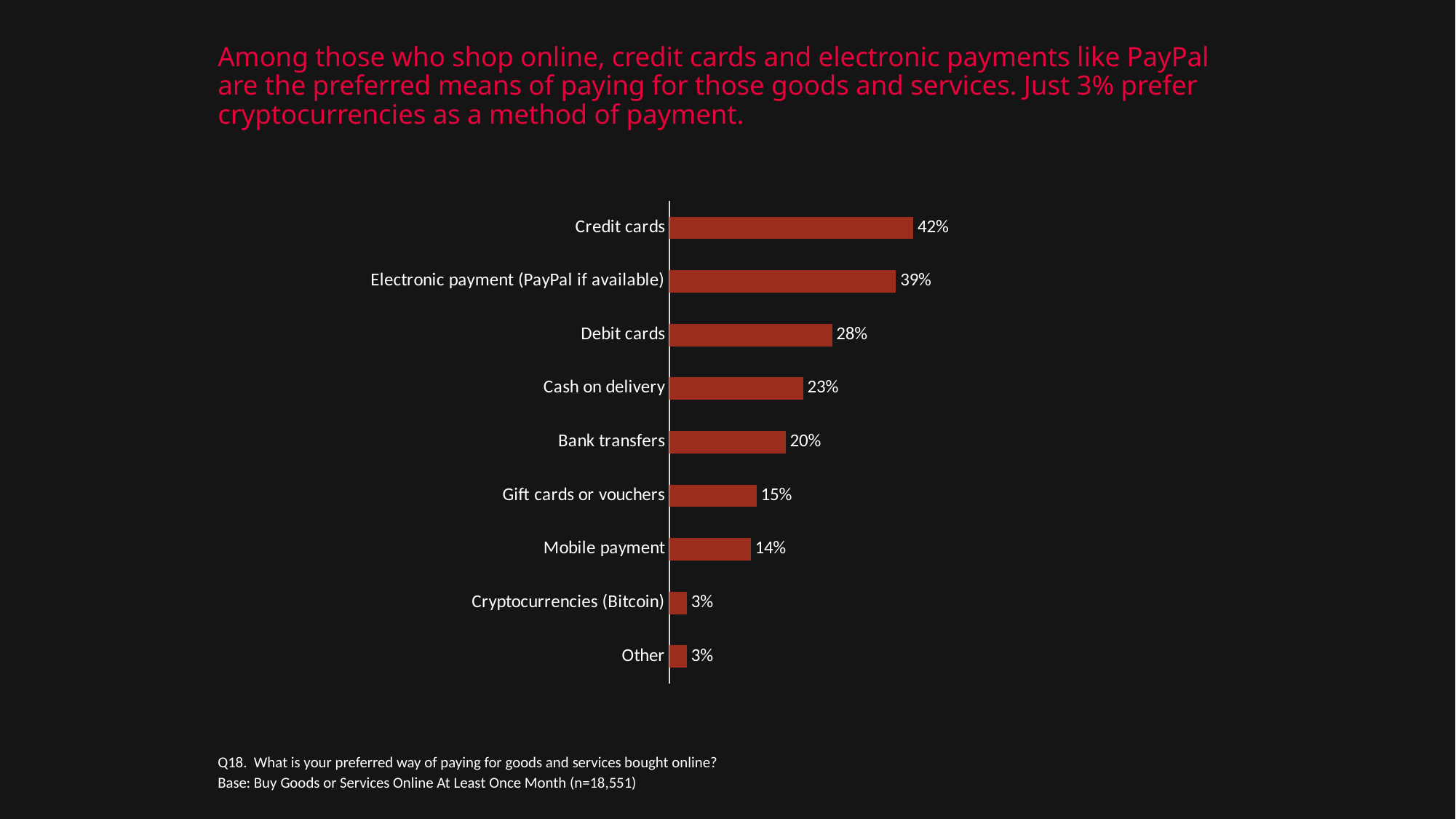
What percentage of online shoppers prefer credit cards as a payment method? 42% How many payment method categories are shown in the chart? 9 What is the difference between the values for Credit cards and Debit cards? 14% What is the value shown for Electronic payment (PayPal if available)? 39% What is the sample size (n) given in the base note below the chart? 18,551 What is the difference between Bank transfers and Gift cards or vouchers? 5% What is the value for Mobile payment? 14% What percentage prefer Cash on delivery? 23% Which payment method has the highest percentage? Credit cards Which is larger, the value for Debit cards or the value for Cash on delivery? Debit cards What value is shown for Cryptocurrencies (Bitcoin)? 3% What type of chart is shown on the slide? Bar chart